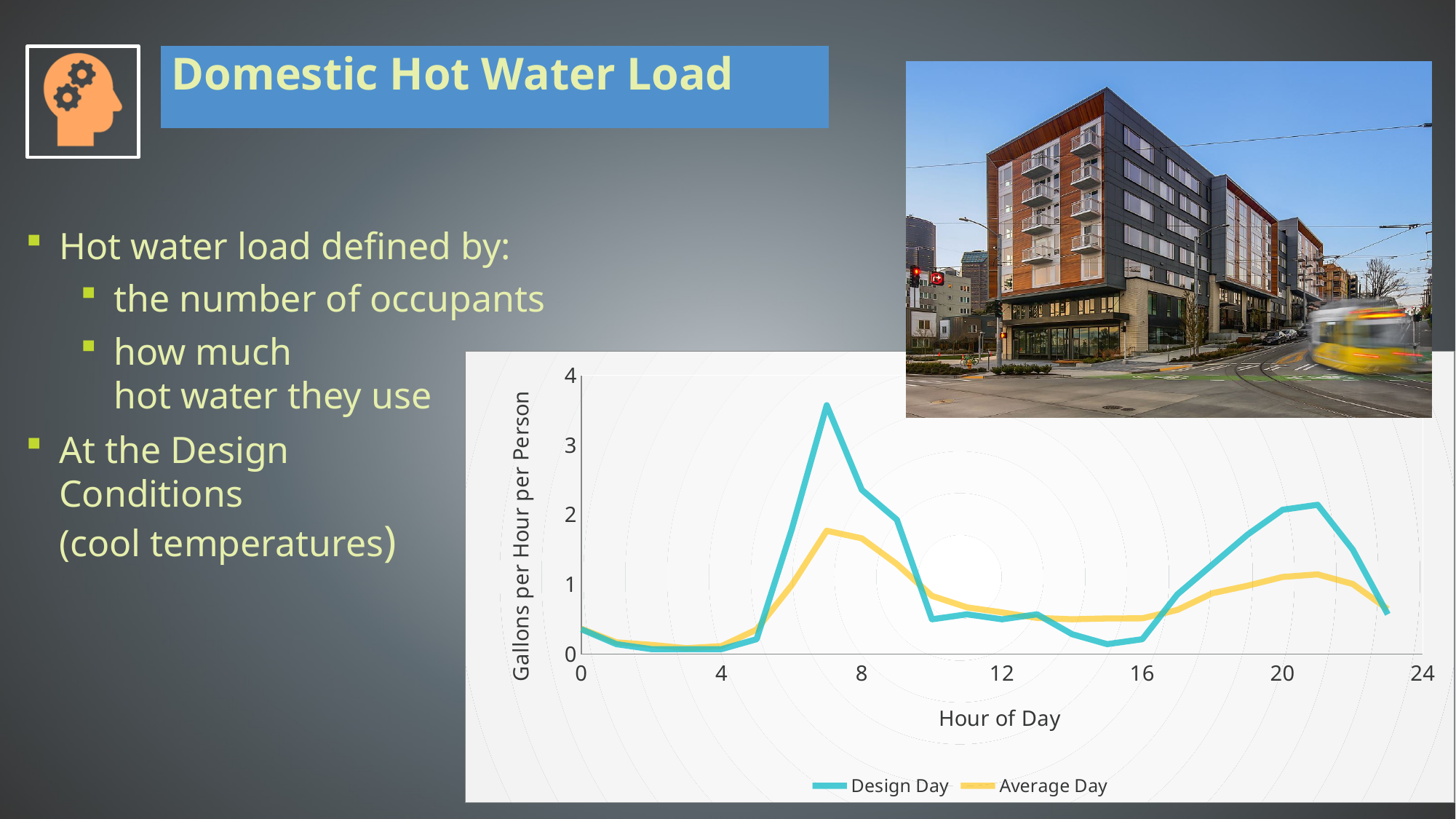
At hour 10, which series has the higher value, Design Day or Average Day? Average Day Is the Design Day value at hour 15 greater or less than 1? less Between hour 4 and hour 7, does the Design Day line rise or fall? rise What are the two series named in the chart's legend? Design Day and Average Day What kind of chart is shown on the slide? line chart What is the title of the chart's vertical axis? Gallons per Hour per Person Is the Average Day value at hour 7 greater or less than 2? less Is the Design Day value at hour 7 greater or less than 3? greater At hour 20, which series has the higher value, Design Day or Average Day? Design Day At which hour of the day does the Average Day line reach its highest value? 7 At which hour of the day does the Design Day line reach its highest value? 7 How many series does the chart's legend list? 2